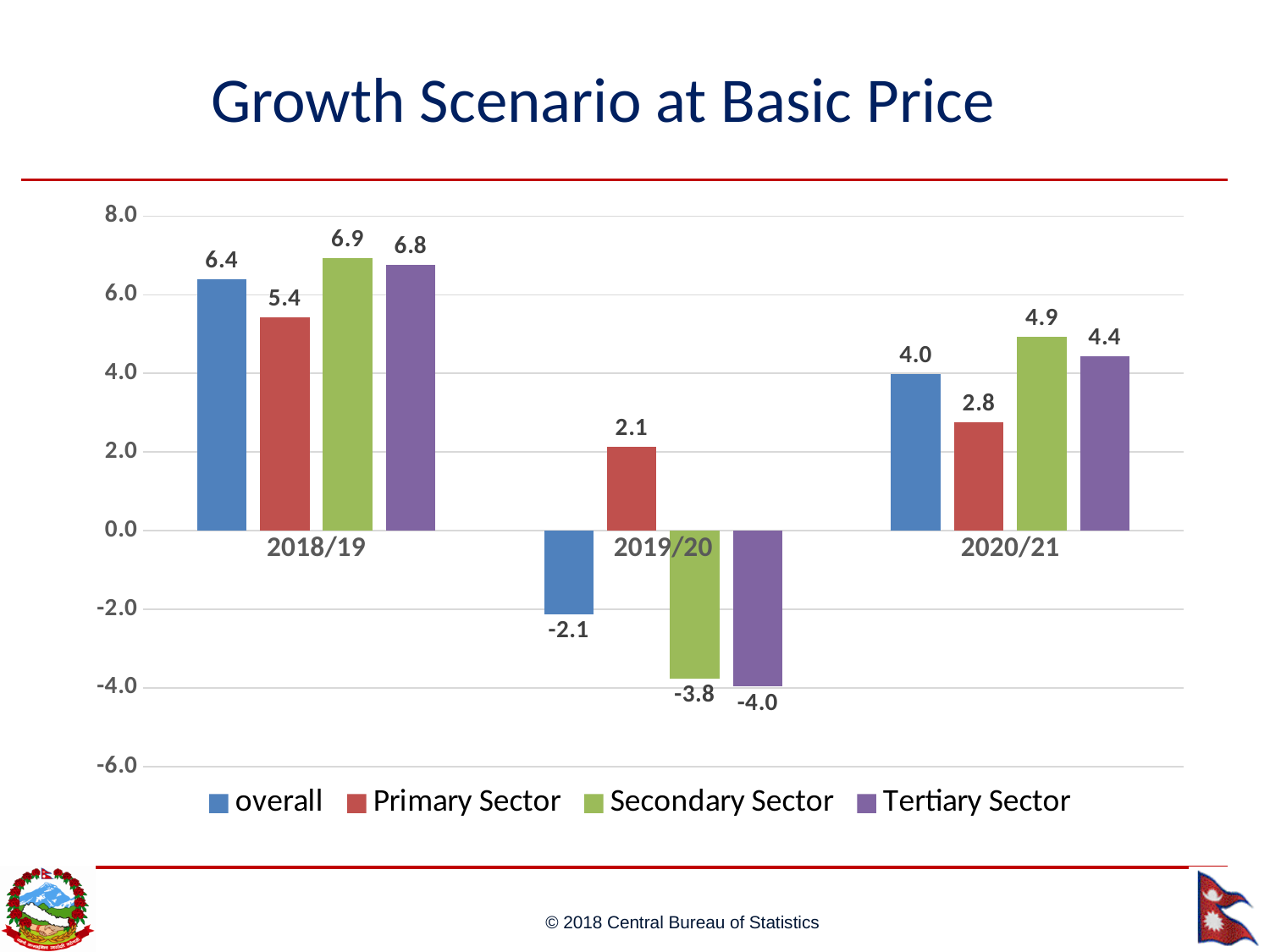
Which series has the highest value in 2018/19? Secondary Sector Which is larger, the Primary Sector value for 2018/19 or for 2020/21? 2018/19 What is the title of the chart? Growth Scenario at Basic Price What is the Tertiary Sector value for 2020/21? 4.4 Does the overall growth value rise or fall from 2018/19 to 2019/20? Fall What is the Secondary Sector value for 2019/20? -3.8 How many year categories are shown on the x axis? 3 What kind of chart is shown on the slide? Bar chart Which series has the lowest value in 2019/20? Tertiary Sector What is the difference between the Secondary Sector values for 2018/19 and 2020/21? 2.0 What is the overall growth value for 2018/19? 6.4 How many series does the legend list? 4